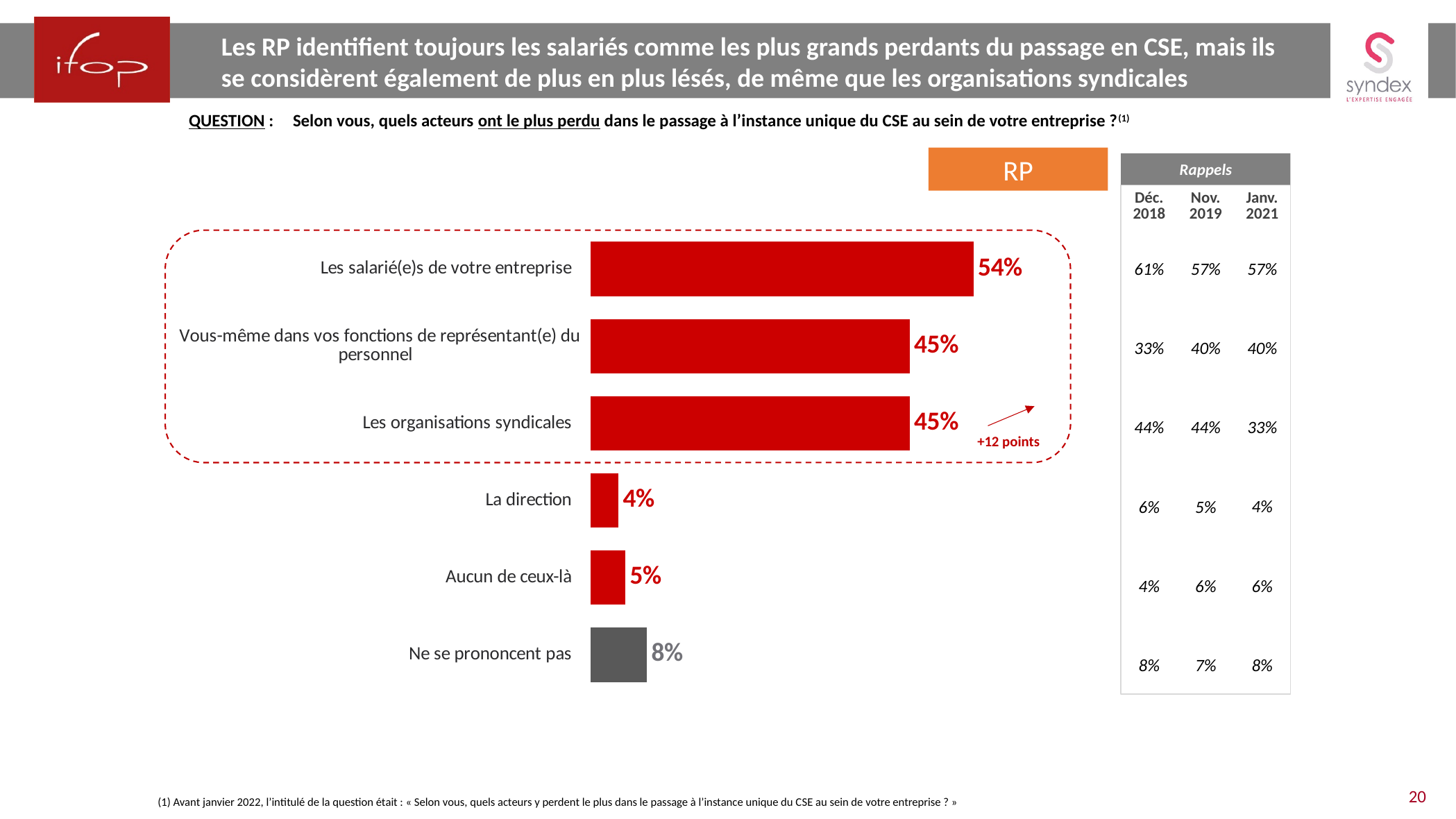
What is the value for "Ne se prononcent pas"? 8% Which category has the lowest value? La direction Which is larger, the value for "Aucun de ceux-là" or the value for "La direction"? Aucun de ceux-là What is the value for "Les salarié(e)s de votre entreprise"? 54% Which category has the highest value? Les salarié(e)s de votre entreprise What kind of chart is shown on the slide? Bar chart What is the value for "Les organisations syndicales"? 45% What is the difference between the values for "Ne se prononcent pas" and "Aucun de ceux-là"? 3% How many categories are shown in the bar chart? 6 What is the change in points indicated by the arrow next to "Les organisations syndicales"? +12 points What is the difference between the values for "Les salarié(e)s de votre entreprise" and "Les organisations syndicales"? 9% What is the value for "La direction"? 4%